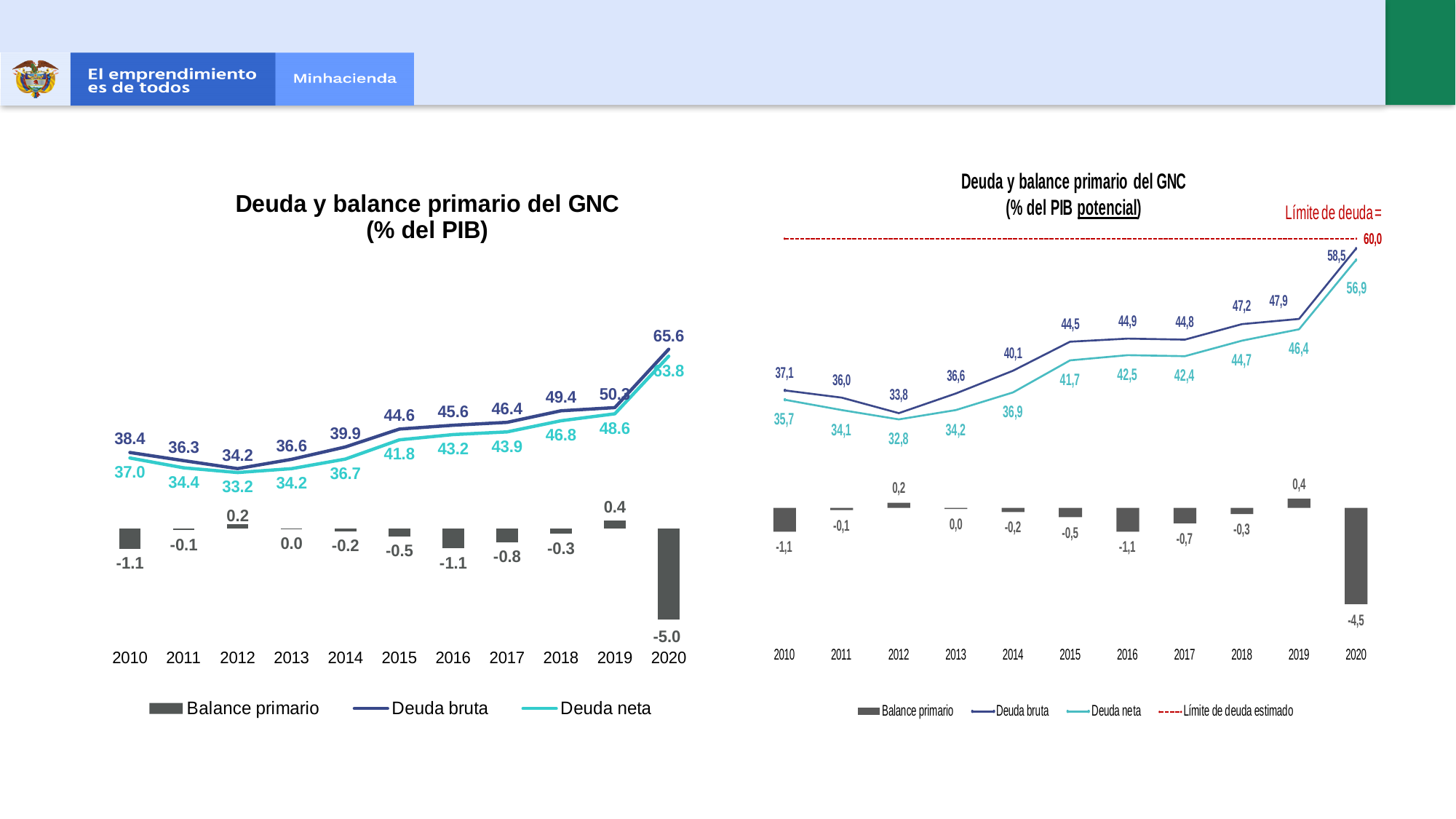
In the left chart (% del PIB), which year has the lowest Deuda bruta value? 2012 In the right chart (% del PIB potencial), which year has the highest Balance primario value? 2019 In the left chart (% del PIB), what is the Balance primario value for 2020? -5.0 In the left chart (% del PIB), what is the Deuda bruta value for 2020? 65.6 In the right chart (% del PIB potencial), what is the Deuda bruta value for 2020? 58,5 In the left chart (% del PIB), how many series does the legend list? 3 In the left chart (% del PIB), what is the Deuda neta value for 2015? 41.8 In the right chart (% del PIB potencial), what value is shown for the Límite de deuda estimado line? 60,0 In the left chart (% del PIB), what is the difference between Deuda bruta and Deuda neta in 2010? 1.4 In the right chart (% del PIB potencial), what is the Balance primario value for 2016? -1,1 In the right chart (% del PIB potencial), what is the Deuda neta value for 2019? 46,4 How many years are shown on the x axis of the left chart (% del PIB)? 11